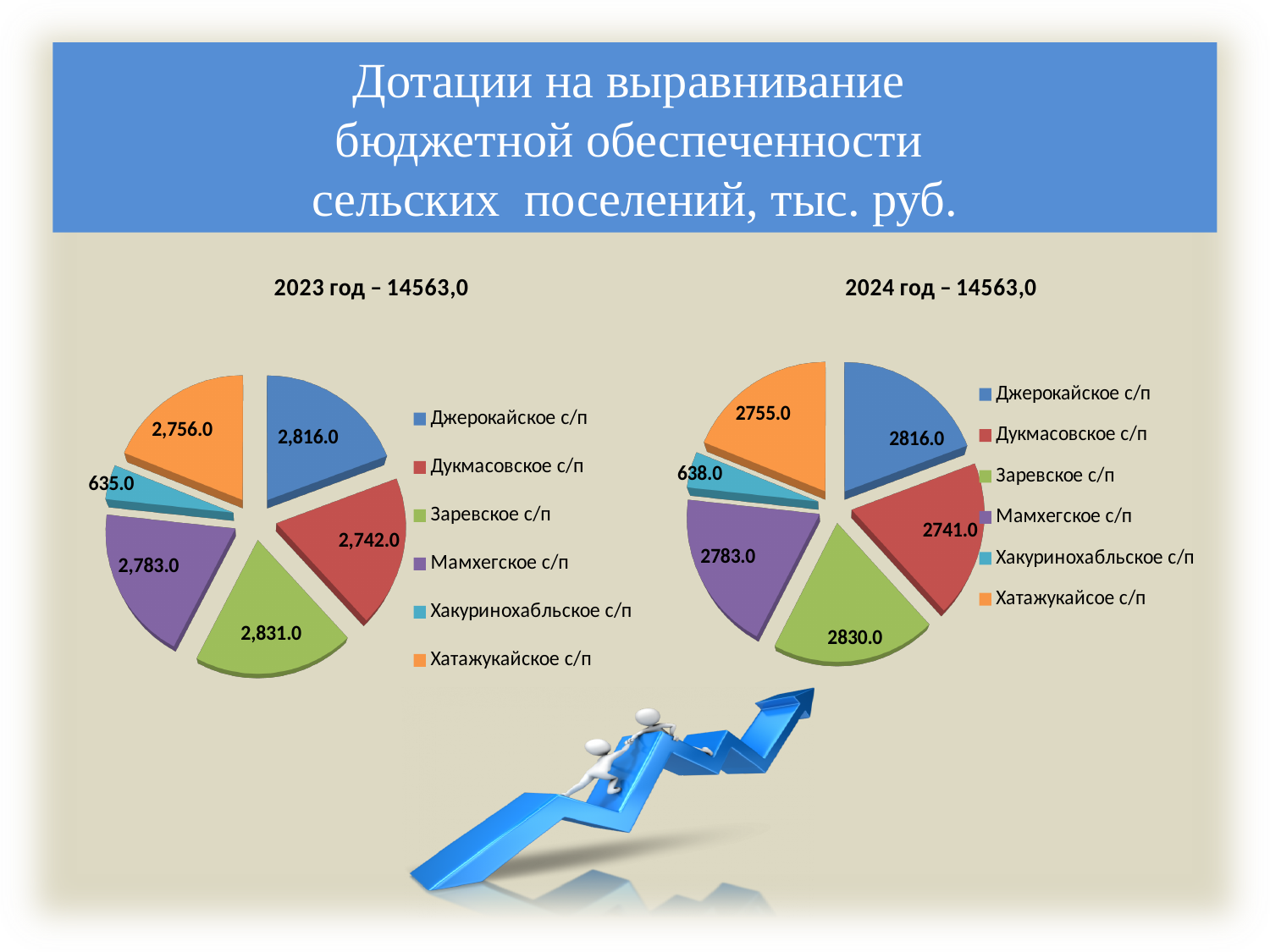
On the 2023 pie chart (left), what is the difference between the values for Заревское с/п and Хакуринохабльское с/п? 2,196.0 On the 2023 pie chart (left), which settlement has the smallest value? Хакуринохабльское с/п On the 2023 pie chart (left), which is larger: the value for Дукмасовское с/п or the value for Хатажукайское с/п? Хатажукайское с/п On the 2023 pie chart (left), what is the value for Джерокайское с/п? 2,816.0 On the 2024 pie chart (right), which settlement has the largest value? Заревское с/п On the 2024 pie chart (right), what is the difference between the values for Джерокайское с/п and Хатажукайсое с/п? 61.0 On the 2023 pie chart (left), what is the value for Мамхегское с/п? 2,783.0 What type of chart is used to show the 2023 data on the left? Pie chart How many slices does the 2024 pie chart (right) have? 6 On the 2024 pie chart (right), what is the value for Хакуринохабльское с/п? 638.0 What total is shown in the heading above the 2023 pie chart (left)? 14563,0 On the 2024 pie chart (right), what is the value for Дукмасовское с/п? 2741.0